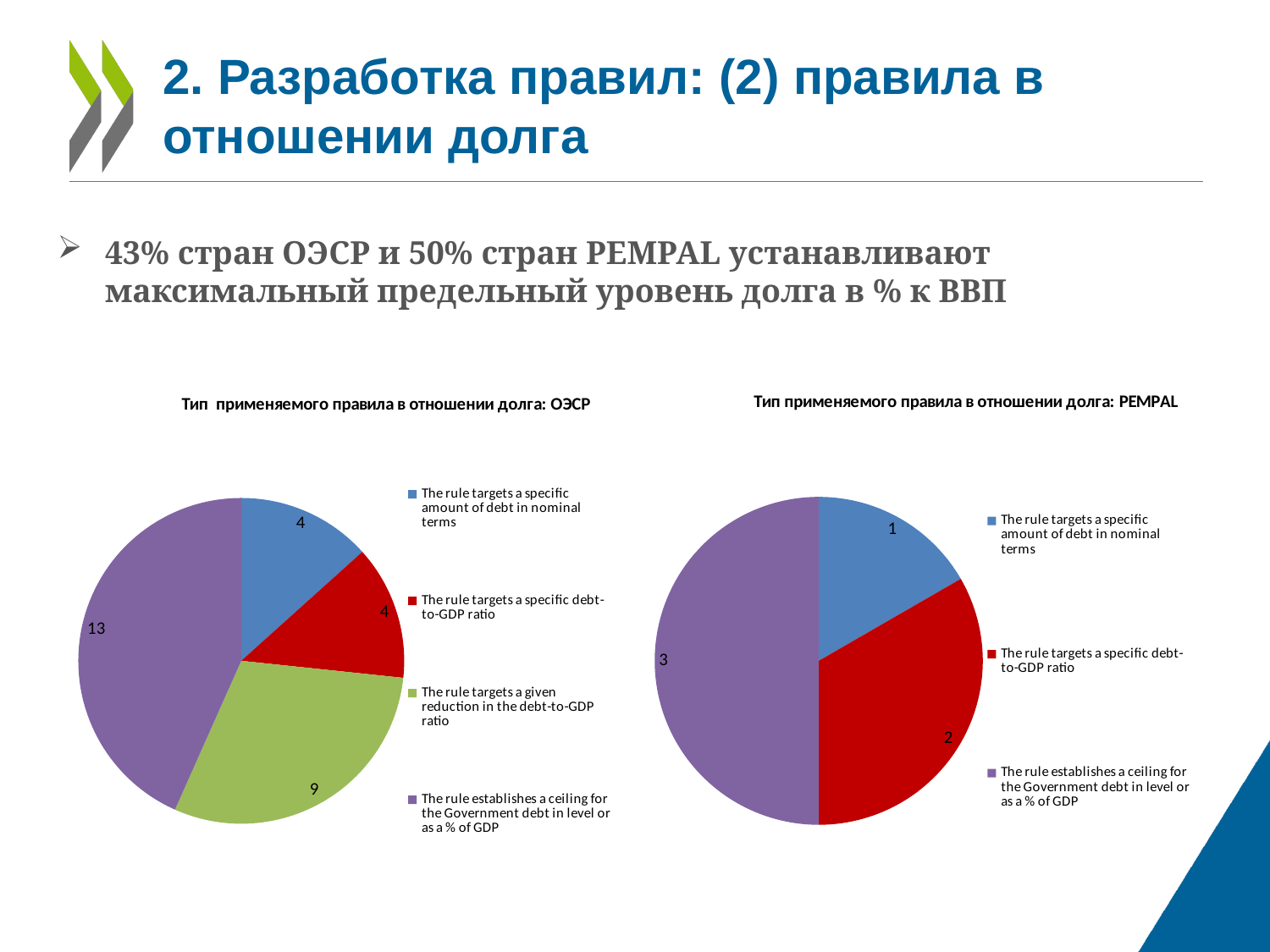
In the ОЭСР pie chart, what is the value for 'The rule targets a given reduction in the debt-to-GDP ratio'? 9 In the PEMPAL pie chart, what is the value for 'The rule targets a specific debt-to-GDP ratio'? 2 In the ОЭСР pie chart, what is the difference between the value for the ceiling on Government debt and the value for a given reduction in the debt-to-GDP ratio? 4 In the PEMPAL pie chart, what is the value for 'The rule targets a specific amount of debt in nominal terms'? 1 How many entries does the legend of the ОЭСР pie chart list? 4 In the ОЭСР pie chart, which category has the largest slice? The rule establishes a ceiling for the Government debt in level or as a % of GDP What type of chart is used on the left, titled 'Тип применяемого правила в отношении долга: ОЭСР'? pie chart In the PEMPAL pie chart, which category has the smallest slice? The rule targets a specific amount of debt in nominal terms In the PEMPAL pie chart, what share of the pie does 'The rule establishes a ceiling for the Government debt in level or as a % of GDP' represent? 50% In the ОЭСР pie chart, is the value for 'The rule targets a specific debt-to-GDP ratio' larger or smaller than the value for 'The rule targets a given reduction in the debt-to-GDP ratio'? smaller In the ОЭСР pie chart, what is the value for 'The rule establishes a ceiling for the Government debt in level or as a % of GDP'? 13 How many slices does the PEMPAL pie chart have? 3